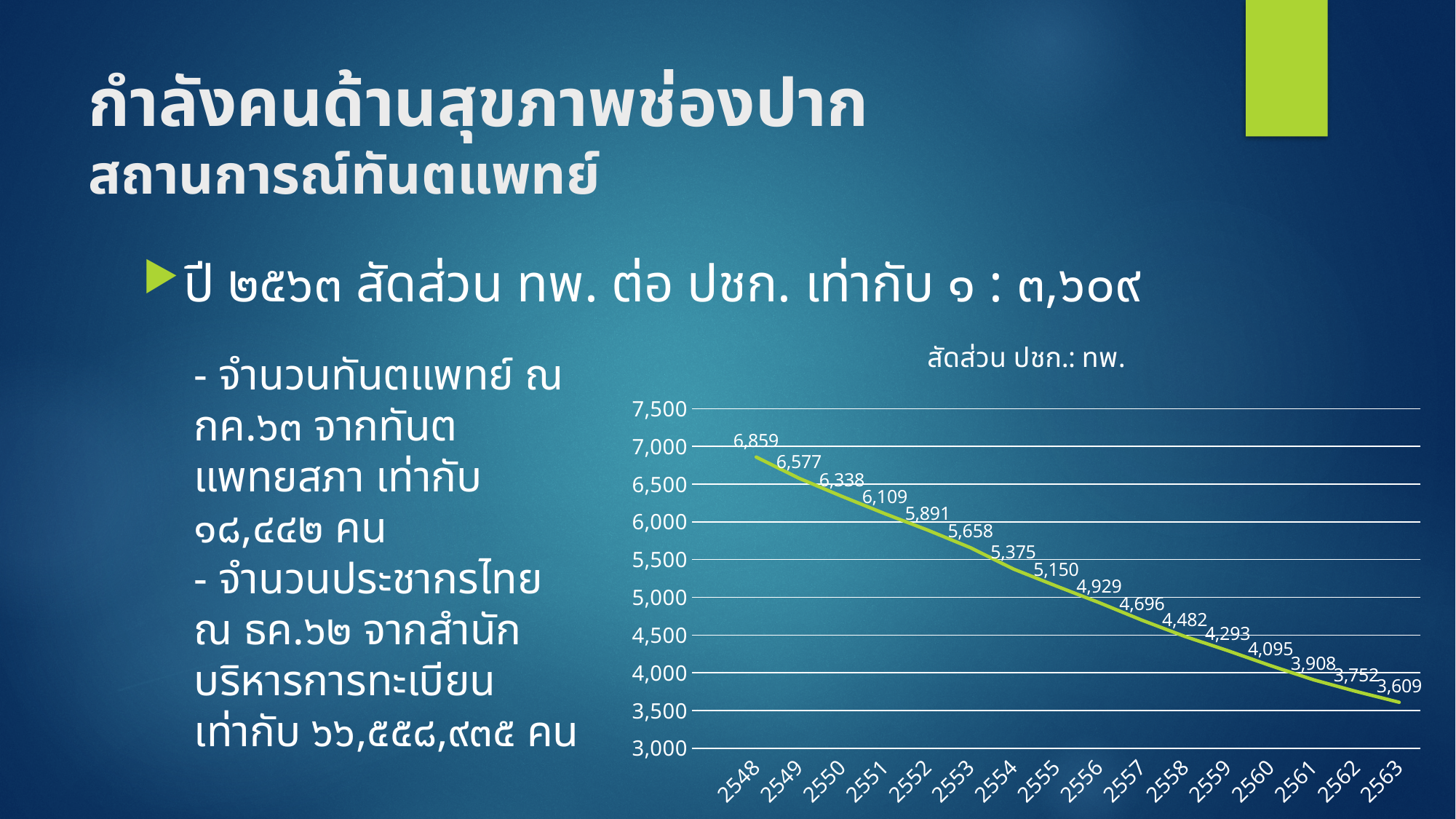
How many years are plotted on the x axis? 16 What is the value for 2563? 3,609 What type of chart is shown on the slide? line chart What is the value for 2548? 6,859 What is the value for 2560? 4,095 Do the values rise or fall from 2548 to 2563? fall Which is larger, the value for 2552 or the value for 2558? 2552 What is the difference between the values for 2548 and 2563? 3,250 Which year has the lowest value? 2563 What is the value for 2555? 5,150 What is the title of the chart? สัดส่วน ปชก.: ทพ. Which year has the highest value? 2548